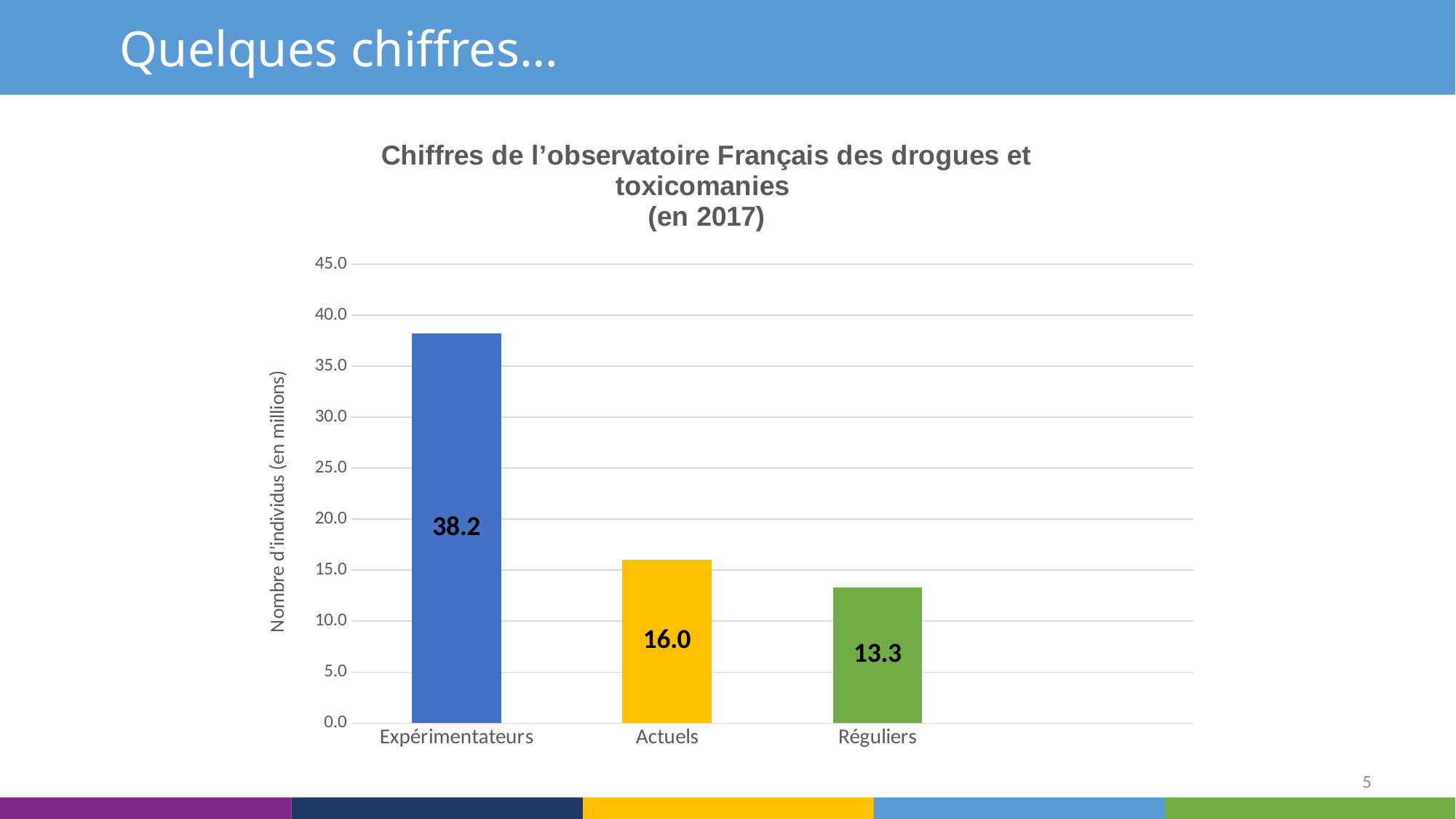
What is the difference between the values for Actuels and Réguliers? 2.7 Which is larger, the value for Actuels or the value for Réguliers? Actuels Which category has the lowest value? Réguliers Is the value for Expérimentateurs greater or less than 35.0? greater What kind of chart is shown on the slide? bar chart How many categories are shown on the x axis? 3 Which category has the highest value? Expérimentateurs What is the value for Expérimentateurs? 38.2 What is the value for Actuels? 16.0 What is the difference between the values for Expérimentateurs and Actuels? 22.2 What is the value for Réguliers? 13.3 What is the label of the vertical axis? Nombre d'individus (en millions)